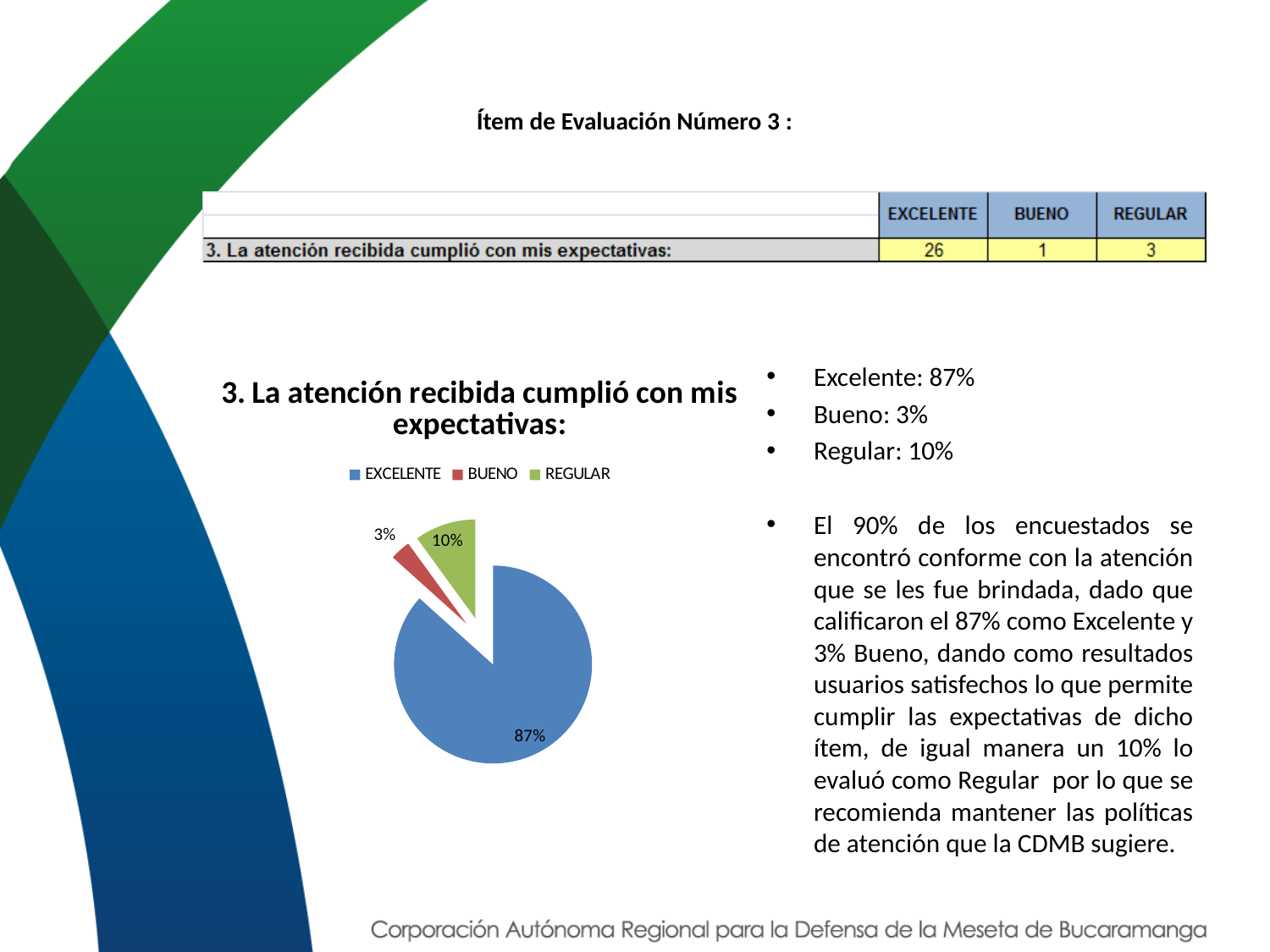
How many entries does the legend of the pie chart list? 3 Which slice is larger, REGULAR or BUENO? REGULAR What is the title of the pie chart? 3. La atención recibida cumplió con mis expectativas: Which colour represents EXCELENTE in the pie chart? blue Which category has the smallest slice in the pie chart? BUENO What is the difference in percentage points between the EXCELENTE and REGULAR slices? 77% What share of the pie does REGULAR represent? 10% What share of the pie does BUENO represent? 3% How many slices does the pie chart have? 3 What share of the pie does EXCELENTE represent? 87% What kind of chart is shown on the slide? pie chart Which category has the largest slice in the pie chart? EXCELENTE